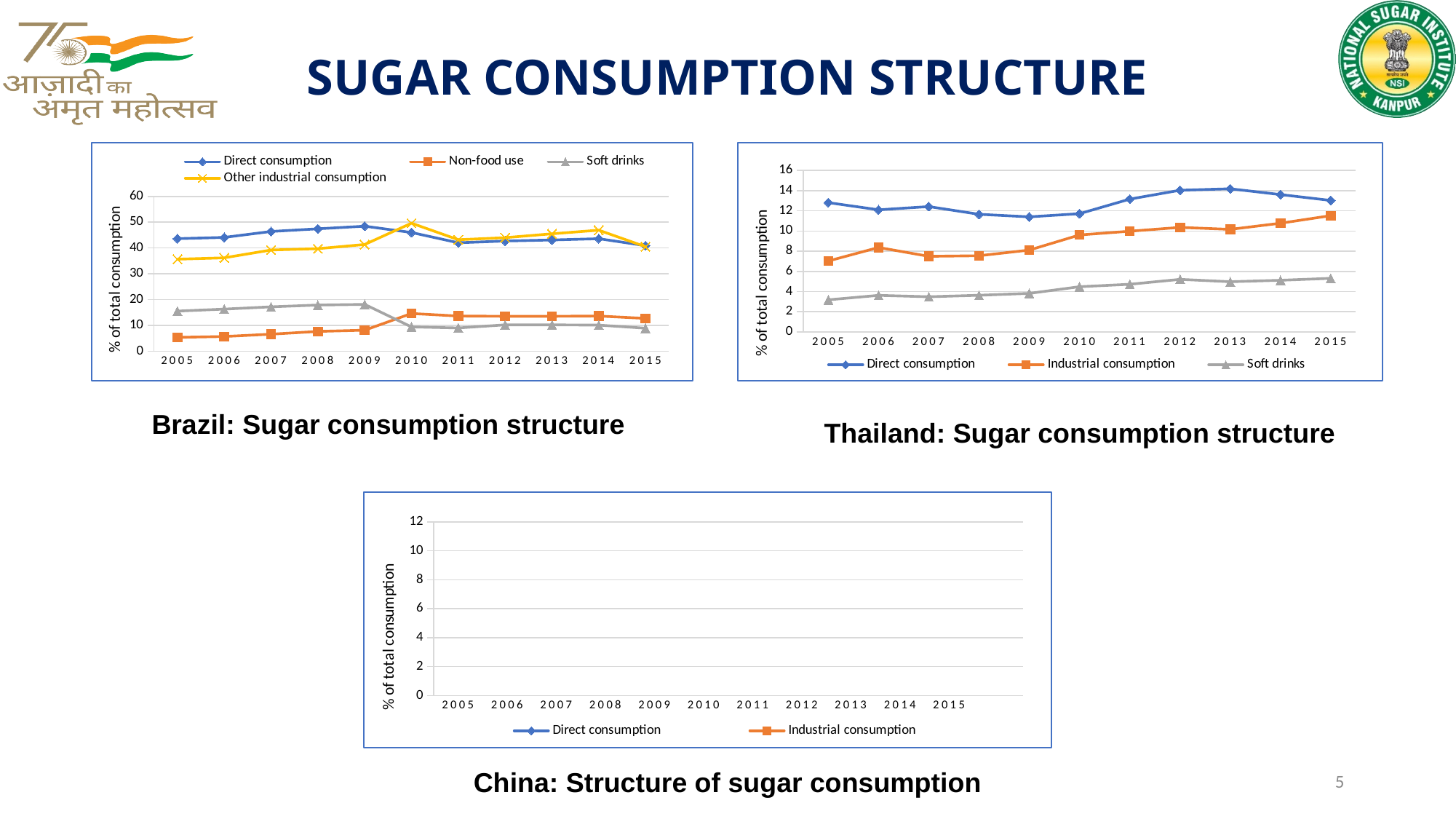
In the Brazil: Sugar consumption structure chart, is the value for Non-food use in 2005 greater or less than 10? less How many series does the legend of the Brazil: Sugar consumption structure chart list? 4 In the Brazil: Sugar consumption structure chart, which is larger in 2005, Direct consumption or Other industrial consumption? Direct consumption How many series does the legend of the China: Structure of sugar consumption chart list? 2 What kind of chart is the Brazil: Sugar consumption structure chart? Line chart In the Thailand: Sugar consumption structure chart, which series has the lowest values across all years? Soft drinks How many series does the legend of the Thailand: Sugar consumption structure chart list? 3 In the Brazil: Sugar consumption structure chart, does Non-food use rise or fall from 2005 to 2010? Rise In the Brazil: Sugar consumption structure chart, is the value for Direct consumption in 2009 greater or less than 40? greater In the Thailand: Sugar consumption structure chart, does Industrial consumption rise or fall overall from 2005 to 2015? Rise How many years are shown on the x axis of the Brazil: Sugar consumption structure chart? 11 In the Thailand: Sugar consumption structure chart, is the value for Industrial consumption in 2015 greater or less than 10? greater